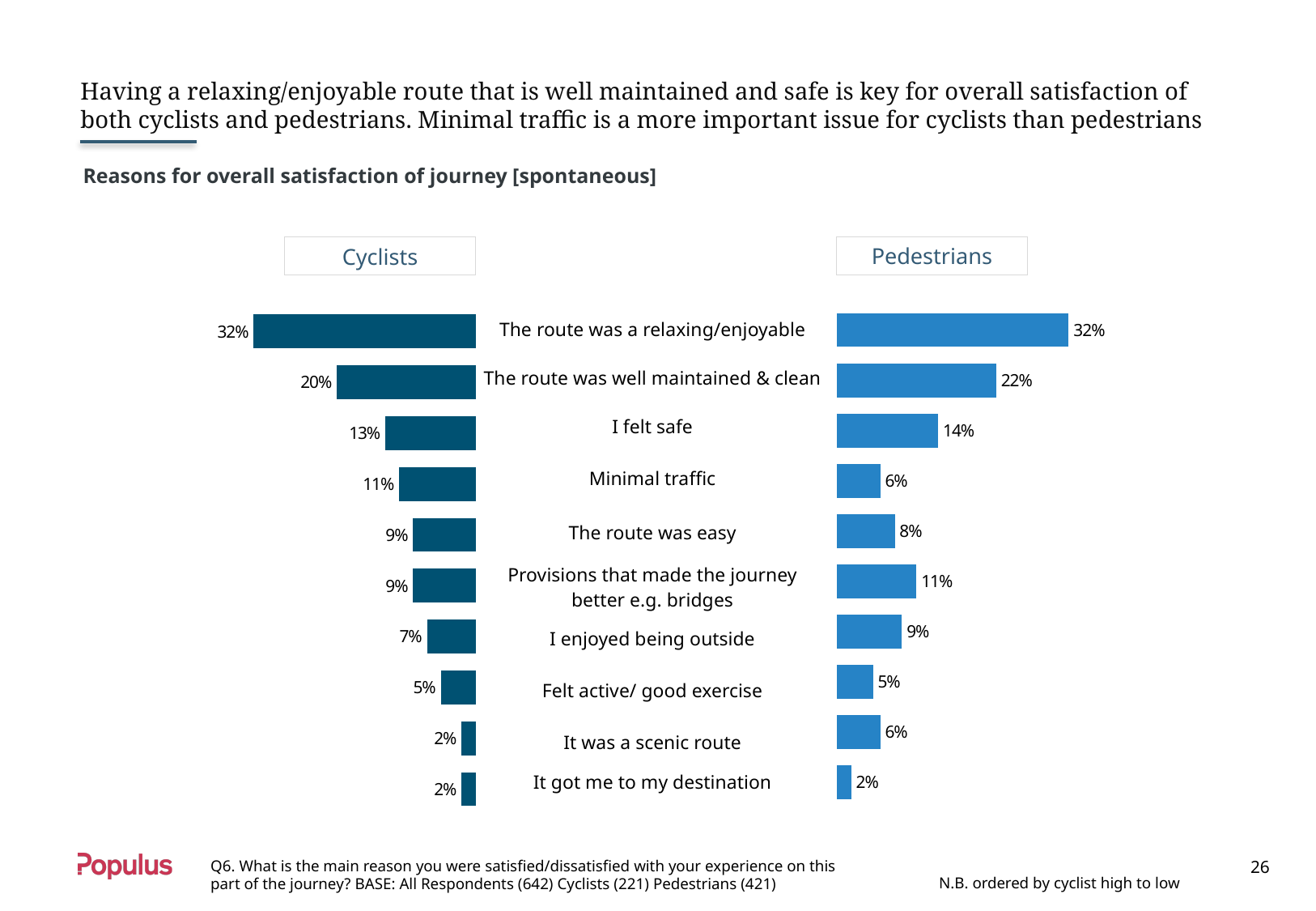
What is the difference between the Cyclists and Pedestrians percentages for 'Minimal traffic'? 5 percentage points In the Pedestrians chart, which reason has the lowest percentage? It got me to my destination In the Cyclists chart, which reason has the highest percentage? The route was a relaxing/enjoyable What is the difference between the Pedestrians percentages for 'The route was a relaxing/enjoyable' and 'I felt safe'? 18 percentage points For 'I felt safe', which group has the higher percentage, Cyclists or Pedestrians? Pedestrians In the Pedestrians chart, what percentage is shown for 'The route was well maintained & clean'? 22% In the Cyclists chart, is the value for 'The route was well maintained & clean' greater or less than 15%? greater In the Cyclists chart, what percentage is shown for 'Minimal traffic'? 11% In the Pedestrians chart, what percentage is shown for 'Provisions that made the journey better e.g. bridges'? 11% What type of chart is used to show the Pedestrians data? Bar chart According to the note on the slide, how are the reasons ordered? By cyclist high to low How many reasons are listed in the Cyclists chart? 10